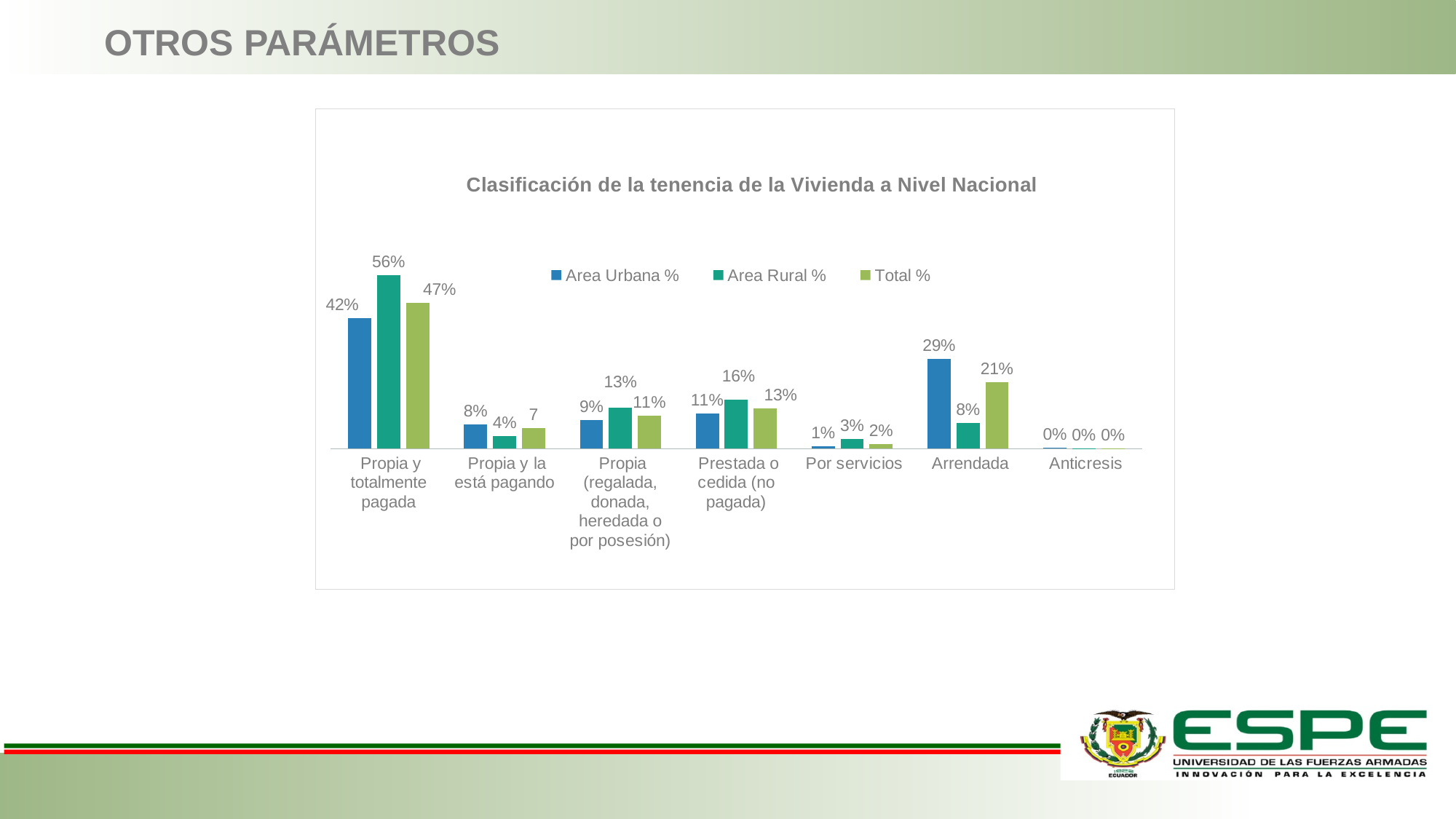
What is the title of the chart? Clasificación de la tenencia de la Vivienda a Nivel Nacional Which category has the highest Total % value? Propia y totalmente pagada Which category has the lowest Area Urbana % value? Anticresis What is the difference between the Area Rural % and Area Urbana % values for Propia y totalmente pagada? 14% What is the Area Rural % value for Por servicios? 3% How many categories are shown on the x axis? 7 What kind of chart is shown on the slide? Bar chart What is the Area Urbana % value for Arrendada? 29% What is the Area Rural % value for Propia y totalmente pagada? 56% What is the Total % value for Prestada o cedida (no pagada)? 13% For Arrendada, which is larger: the Area Urbana % value or the Area Rural % value? Area Urbana % How many series does the legend list? 3